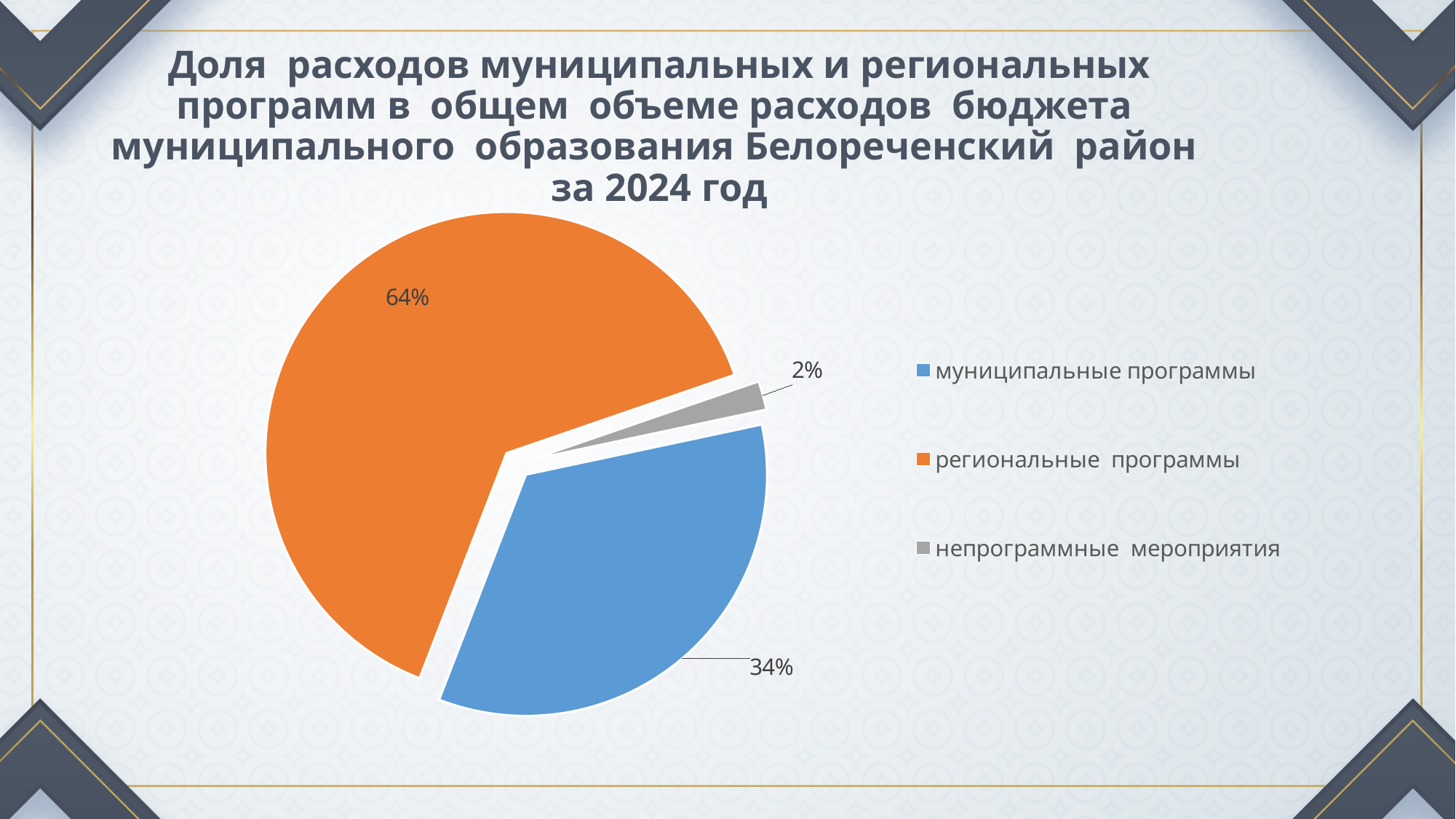
How many entries does the legend list? 3 Which category has the smallest share of the pie? непрограммные мероприятия What kind of chart is shown on the slide? pie chart What colour is the slice for муниципальные программы? blue Which category has the largest share of the pie? региональные программы What year does the chart title refer to? 2024 How many slices does the pie chart have? 3 What share of expenditures is attributed to муниципальные программы? 34% What share of expenditures is attributed to региональные программы? 64% What is the difference in percentage points between региональные программы and муниципальные программы? 30 What share of expenditures is attributed to непрограммные мероприятия? 2% Which is larger: the share for муниципальные программы or the share for непрограммные мероприятия? муниципальные программы